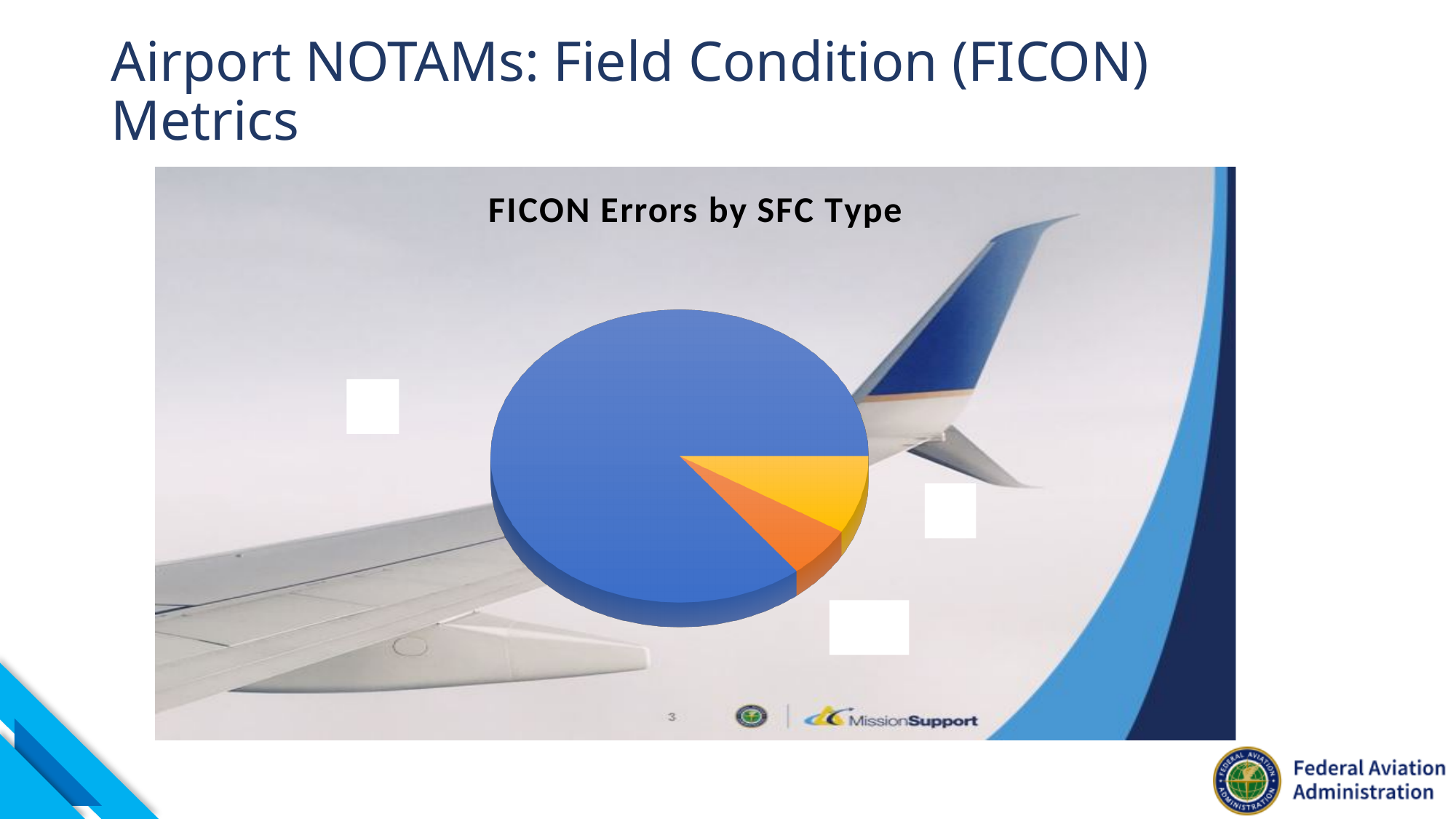
Does the blue slice take up more or less than half of the pie? more What is the title of the chart? FICON Errors by SFC Type What colours are the three slices of the pie chart? blue, orange and yellow Which is larger in the pie chart, the blue slice or the yellow slice? the blue slice How many slices does the pie chart have? 3 Which colour slice is the smallest in the pie chart? orange Which is larger in the pie chart, the yellow slice or the orange slice? the yellow slice Which colour slice is the largest in the pie chart? blue What kind of chart is shown on the slide? pie chart